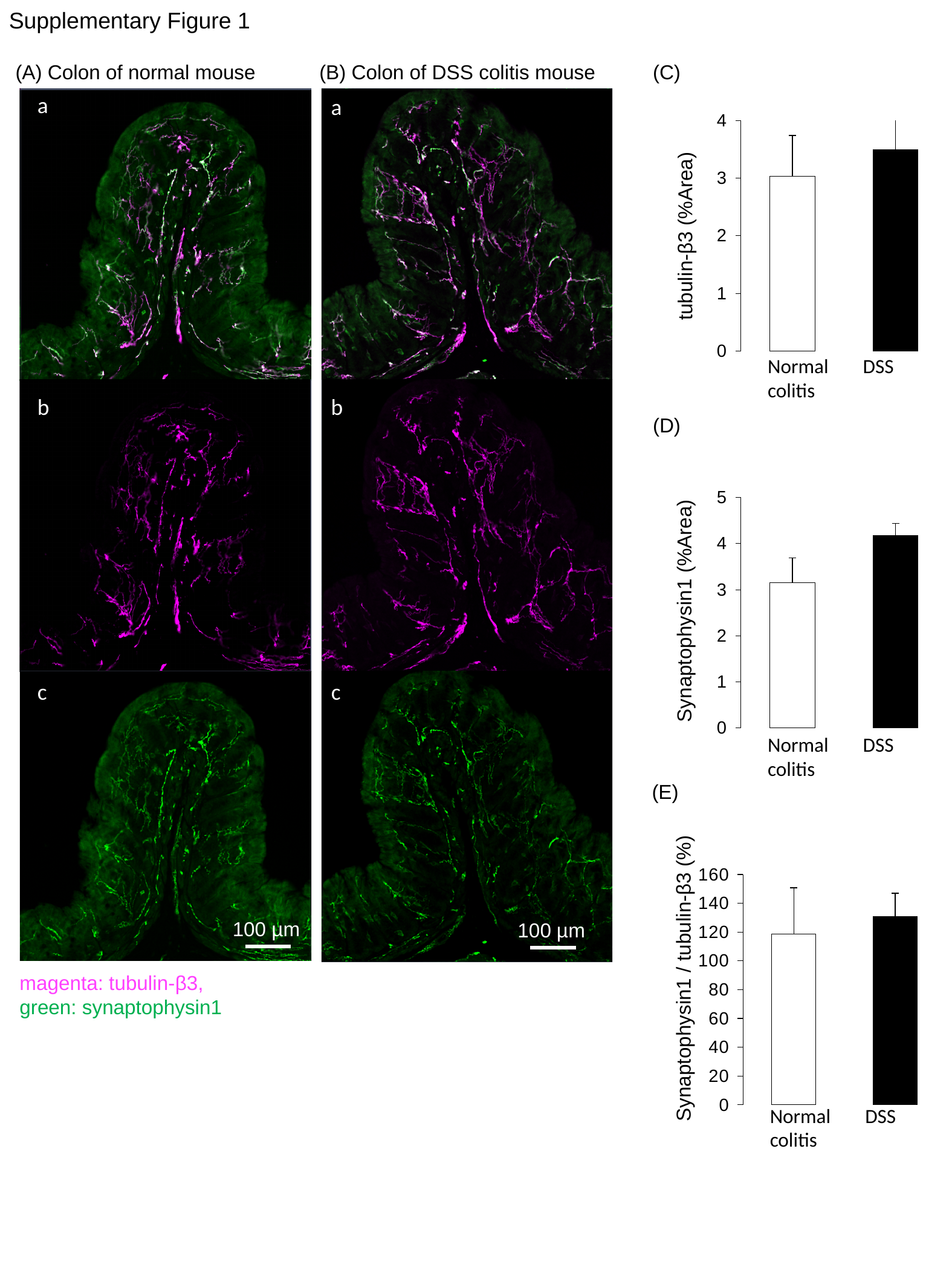
In chart (D), is the value for DSS greater or less than 3? greater In chart (E), what colour is the bar for DSS? black In chart (C), is the value for DSS greater or less than 3? greater In chart (D), which group has the lowest Synaptophysin1 (%Area)? Normal colitis In chart (C), which group has the higher tubulin-β3 (%Area), Normal colitis or DSS? DSS In chart (E), is the value for Normal colitis greater or less than 100? greater In chart (E), which group has the highest Synaptophysin1 / tubulin-β3 (%)? DSS How many bars are plotted in chart (D)? 2 What kind of chart is chart (C)? bar chart What is the y-axis label of chart (D)? Synaptophysin1 (%Area)